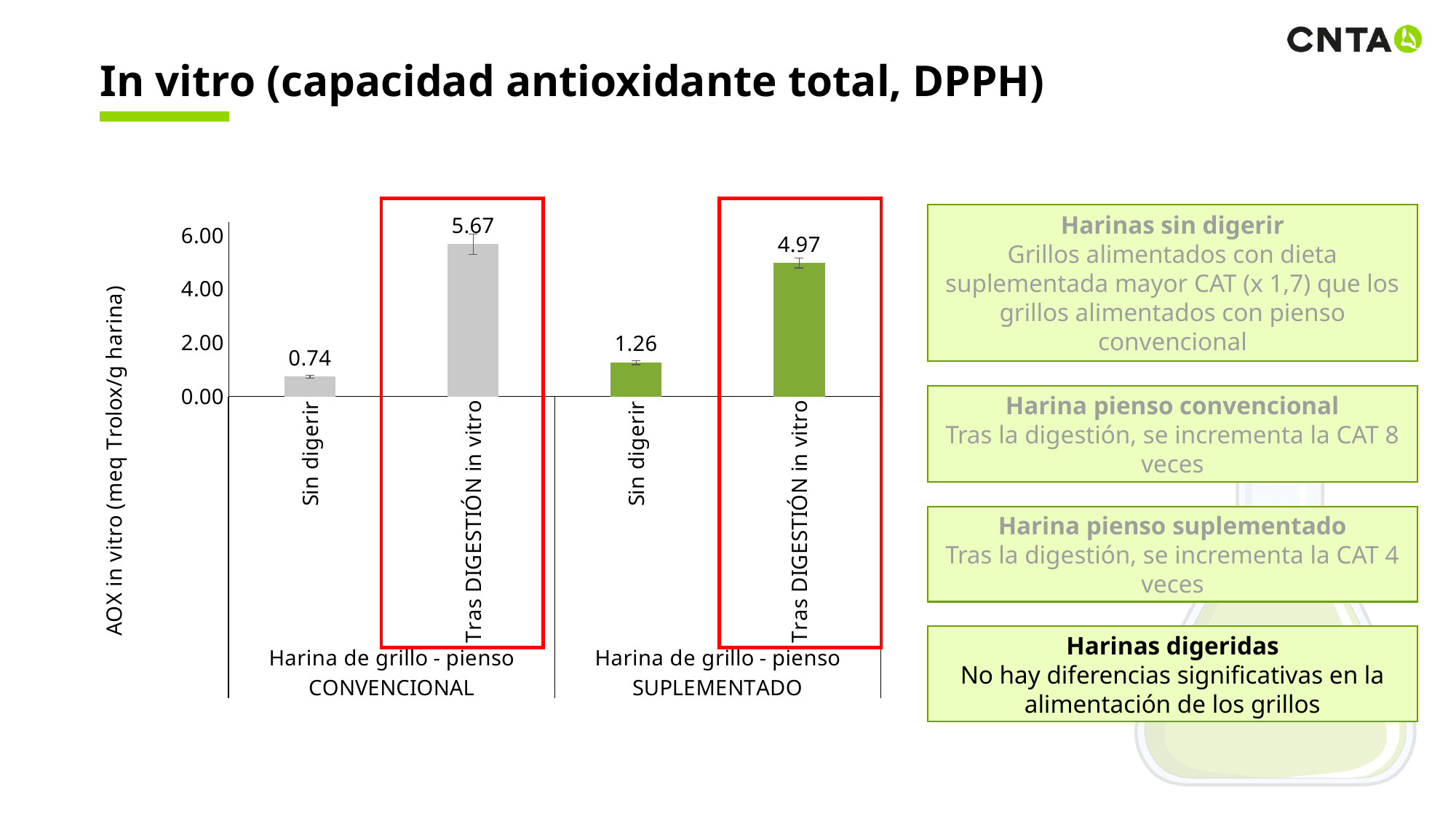
Which bar has the highest value in the chart? Tras DIGESTIÓN in vitro (Harina de grillo - pienso CONVENCIONAL) What is the difference between the 'Tras DIGESTIÓN in vitro' and 'Sin digerir' values in the CONVENCIONAL group? 4.93 What is the value for 'Sin digerir' in the 'Harina de grillo - pienso SUPLEMENTADO' group? 1.26 What is the value for 'Sin digerir' in the 'Harina de grillo - pienso CONVENCIONAL' group? 0.74 What is the difference between the 'Sin digerir' values of the SUPLEMENTADO and CONVENCIONAL groups? 0.52 Which is larger: 'Tras DIGESTIÓN in vitro' in the CONVENCIONAL group or 'Tras DIGESTIÓN in vitro' in the SUPLEMENTADO group? CONVENCIONAL How many bars are plotted in the chart? 4 Which bar has the lowest value in the chart? Sin digerir (Harina de grillo - pienso CONVENCIONAL) What is the label of the vertical axis of the chart? AOX in vitro (meq Trolox/g harina) What is the value for 'Tras DIGESTIÓN in vitro' in the 'Harina de grillo - pienso SUPLEMENTADO' group? 4.97 What is the value for 'Tras DIGESTIÓN in vitro' in the 'Harina de grillo - pienso CONVENCIONAL' group? 5.67 What kind of chart is shown on the slide? Bar chart